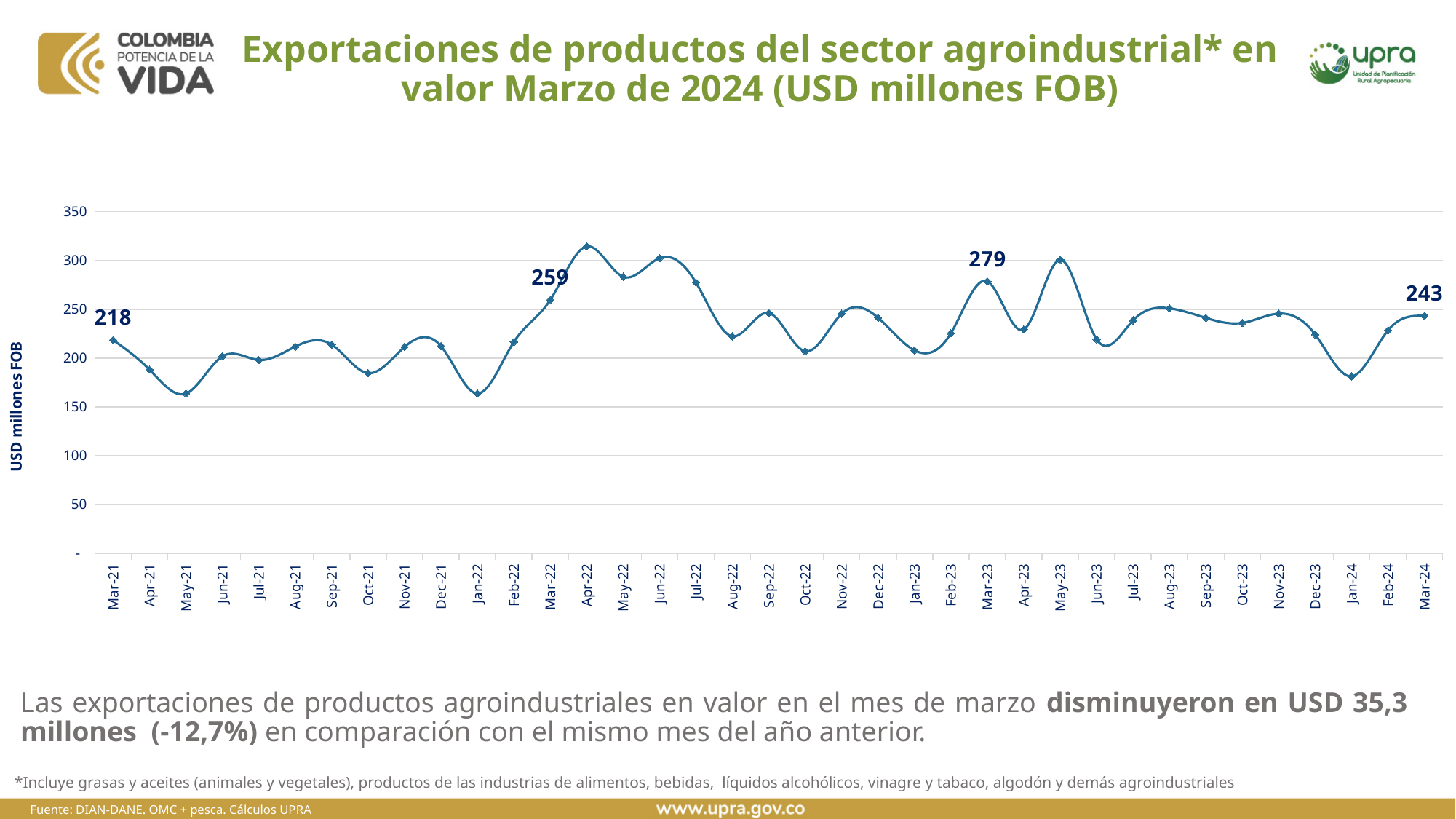
What is the export value for Mar-23? 279 What is the export value for Mar-21? 218 Is the value for Apr-22 greater or less than 300? greater What is the label on the vertical axis of the chart? USD millones FOB What is the export value for Mar-22? 259 How many monthly data points are plotted on the chart? 37 Which is larger, the value for Mar-22 or the value for Mar-23? Mar-23 What type of chart is shown on the slide? Line chart Is the value for Jan-24 greater or less than 200? less What is the difference between the values for Mar-23 and Mar-24? 36 What is the difference between the values for Mar-22 and Mar-21? 41 What is the export value for Mar-24? 243